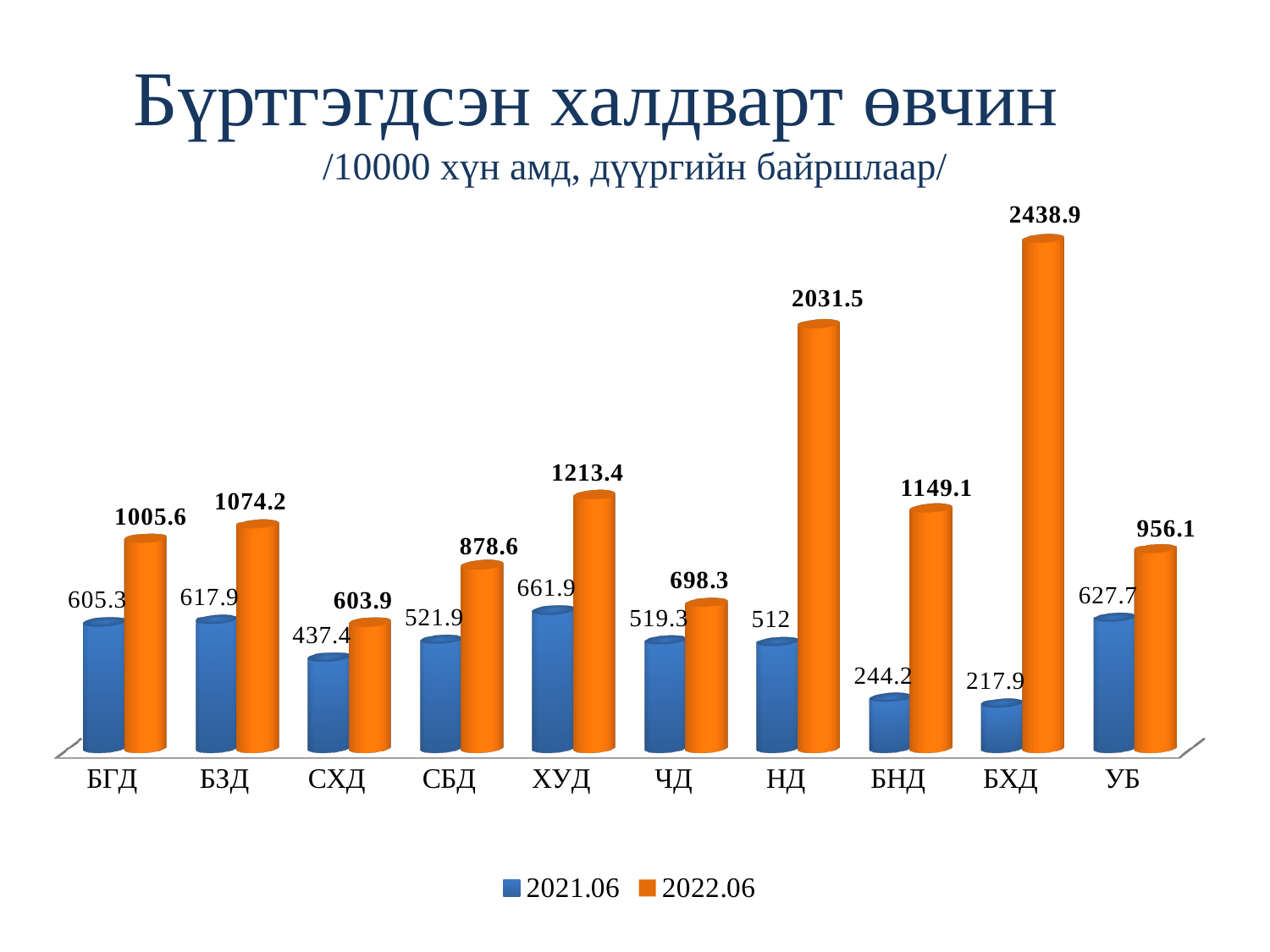
How many series does the legend list? 2 Which is larger for БЗД: the 2021.06 value or the 2022.06 value? 2022.06 What kind of chart is shown on the slide? Bar chart Which category has the highest 2022.06 value? БХД Which colour represents the 2022.06 series? Orange How many categories are shown on the x axis? 10 Which category has the lowest 2021.06 value? БХД What is the 2021.06 value for СХД? 437.4 What is the 2022.06 value for НД? 2031.5 What is the difference between the 2022.06 and 2021.06 values for НД? 1519.5 What is the 2022.06 value for УБ? 956.1 Which category has the lowest 2022.06 value? СХД